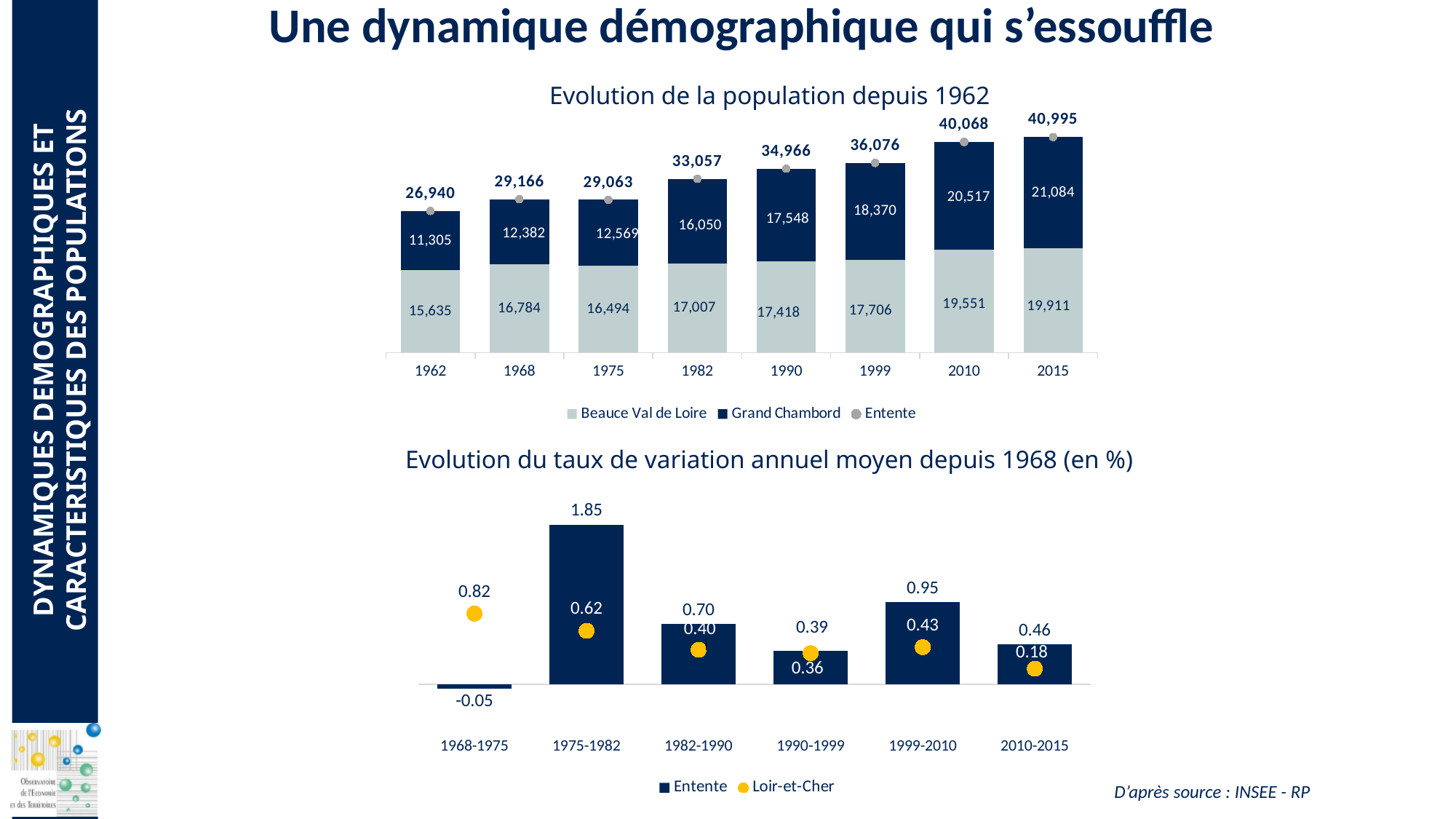
In the chart 'Evolution du taux de variation annuel moyen depuis 1968 (en %)', what is the Loir-et-Cher value for 1968-1975? 0.82 In the chart 'Evolution de la population depuis 1962', which year has the highest Entente total? 2015 In the chart 'Evolution du taux de variation annuel moyen depuis 1968 (en %)', which is larger for 1999-2010: the Entente value or the Loir-et-Cher value? Entente In the chart 'Evolution de la population depuis 1962', what is the difference between the Beauce Val de Loire and Grand Chambord values in 1962? 4,330 In the chart 'Evolution de la population depuis 1962', what is the value for Grand Chambord in 1982? 16,050 In the chart 'Evolution de la population depuis 1962', how many years are shown on the x axis? 8 In the chart 'Evolution de la population depuis 1962', what is the value for Beauce Val de Loire in 2015? 19,911 In the chart 'Evolution de la population depuis 1962', what is the Entente total for 1990? 34,966 In the chart 'Evolution du taux de variation annuel moyen depuis 1968 (en %)', which period has the lowest Entente value? 1968-1975 In the chart 'Evolution du taux de variation annuel moyen depuis 1968 (en %)', what is the Entente value for 1975-1982? 1.85 In the chart 'Evolution de la population depuis 1962', how many entries does the legend list? 3 What kind of chart is 'Evolution de la population depuis 1962'? Stacked bar chart